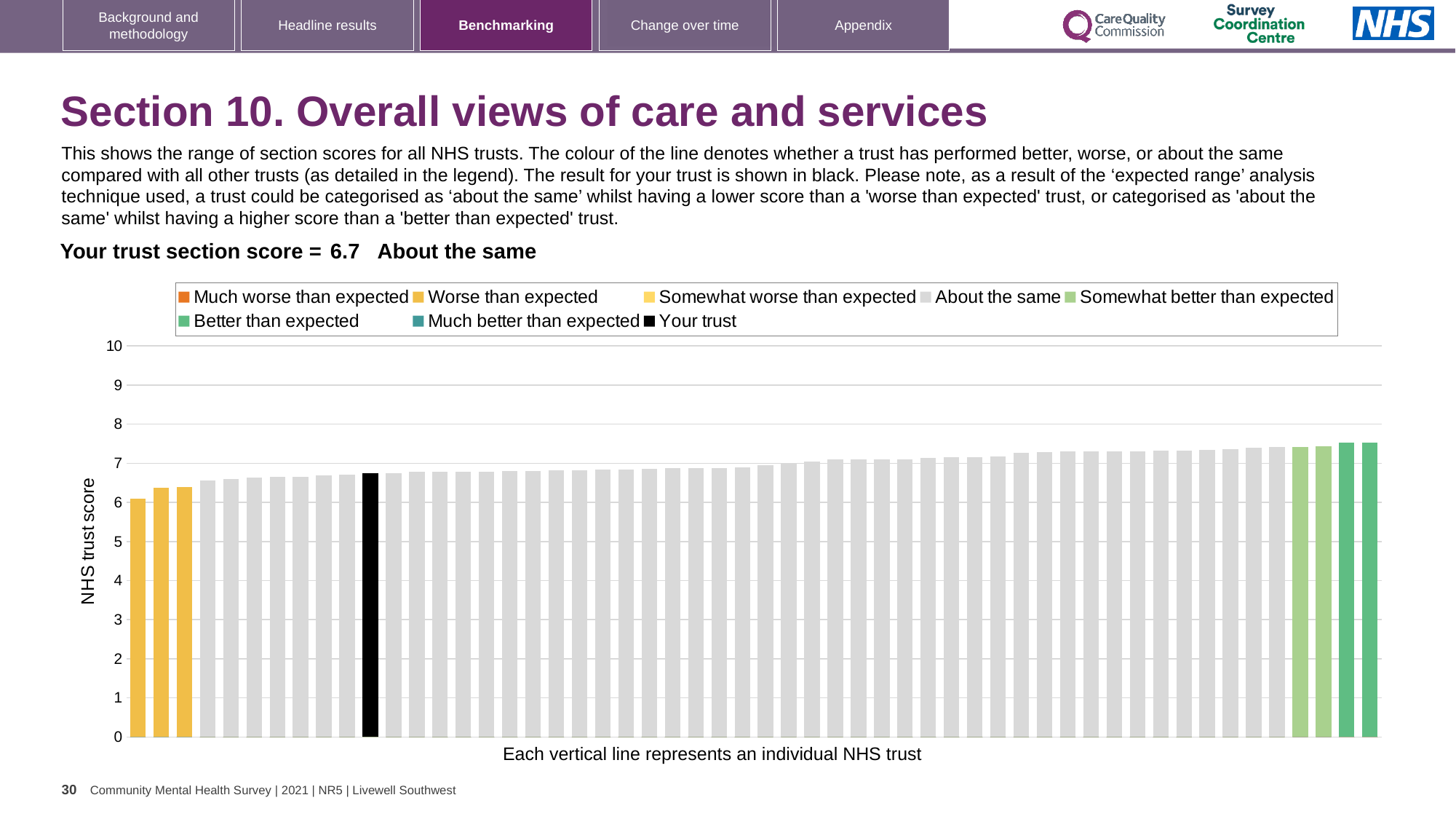
What kind of chart is shown on the slide? Bar chart Is the value for your trust greater or less than 5? greater What is the label on the vertical axis of the chart? NHS trust score Is the value of the highest bar greater or less than 8? less How many entries does the chart legend list? 8 Do the bar values rise or fall from left to right along the x axis? Rise How many bars are coloured as 'Worse than expected'? 3 Which category is your trust placed in according to the slide? About the same Is the value of the lowest bar greater or less than 5? greater What is the section score for your trust shown on the slide? 6.7 Which legend category do the highest bars on the chart belong to? Better than expected How many bars are coloured as 'Better than expected'? 2